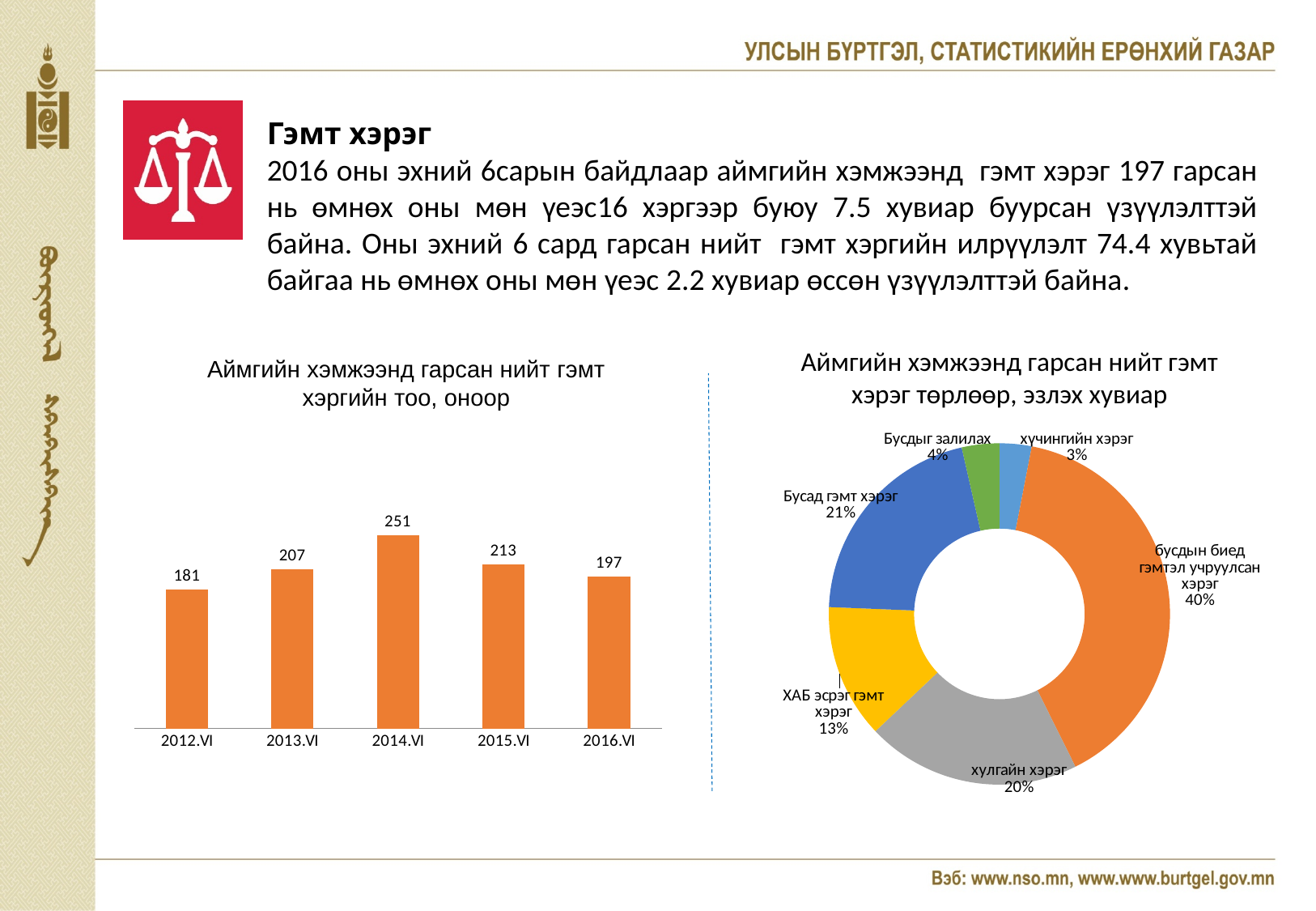
How many bars are in the bar chart on the left? 5 In the bar chart on the left, what is the difference between the values for 2014.VI and 2015.VI? 38 In the bar chart on the left, what is the value for 2014.VI? 251 In the doughnut chart on the right, what share does 'бусдын биед гэмтэл учруулсан хэрэг' have? 40% In the bar chart on the left, which is larger, the value for 2013.VI or 2016.VI? 2013.VI In the bar chart on the left, which year has the highest value? 2014.VI How many categories are shown in the doughnut chart on the right? 6 In the bar chart on the left, which year has the lowest value? 2012.VI In the doughnut chart on the right, which category has the smallest share? хүчингийн хэрэг In the doughnut chart on the right, what share does 'хулгайн хэрэг' have? 20% In the bar chart on the left, what is the value for 2016.VI? 197 What kind of chart is the chart on the left? bar chart